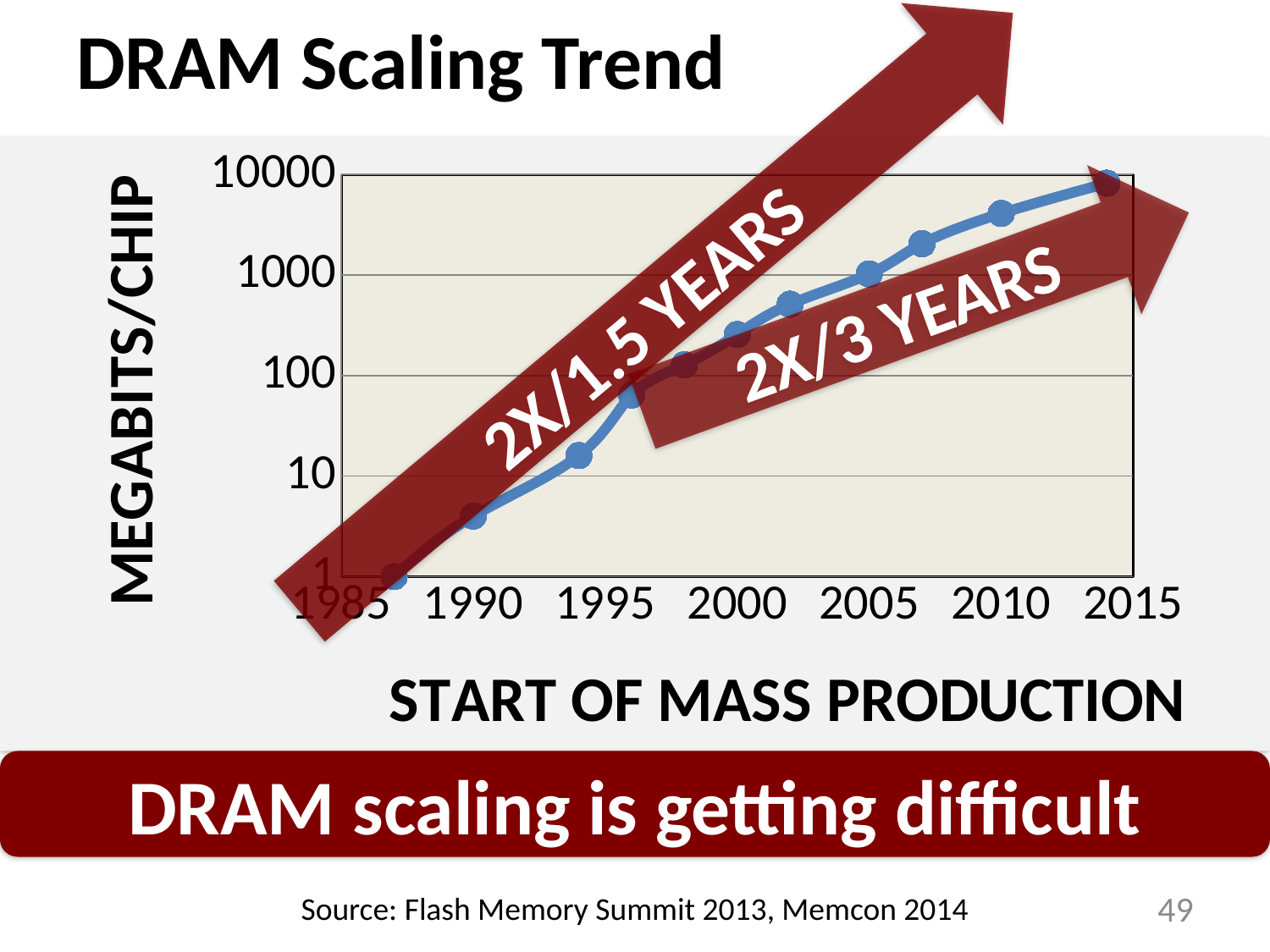
Is the value for the point at 2007 greater or less than 1000 megabits/chip? greater Is the value for the point at 2000 greater or less than 100 megabits/chip? greater Which has the larger megabits/chip value, the point at 1990 or the point at 2010? 2010 What two growth-rate labels are written on the arrows over the chart? 2X/1.5 YEARS and 2X/3 YEARS Is the value for the point at 1990 greater or less than 10 megabits/chip? less Which has the smaller megabits/chip value, the point at 2000 or the point at 1994? 1994 What kind of chart is shown on the slide? line chart What is the title of the y axis? MEGABITS/CHIP Do the megabits per chip values rise or fall as the start of mass production year increases? rise